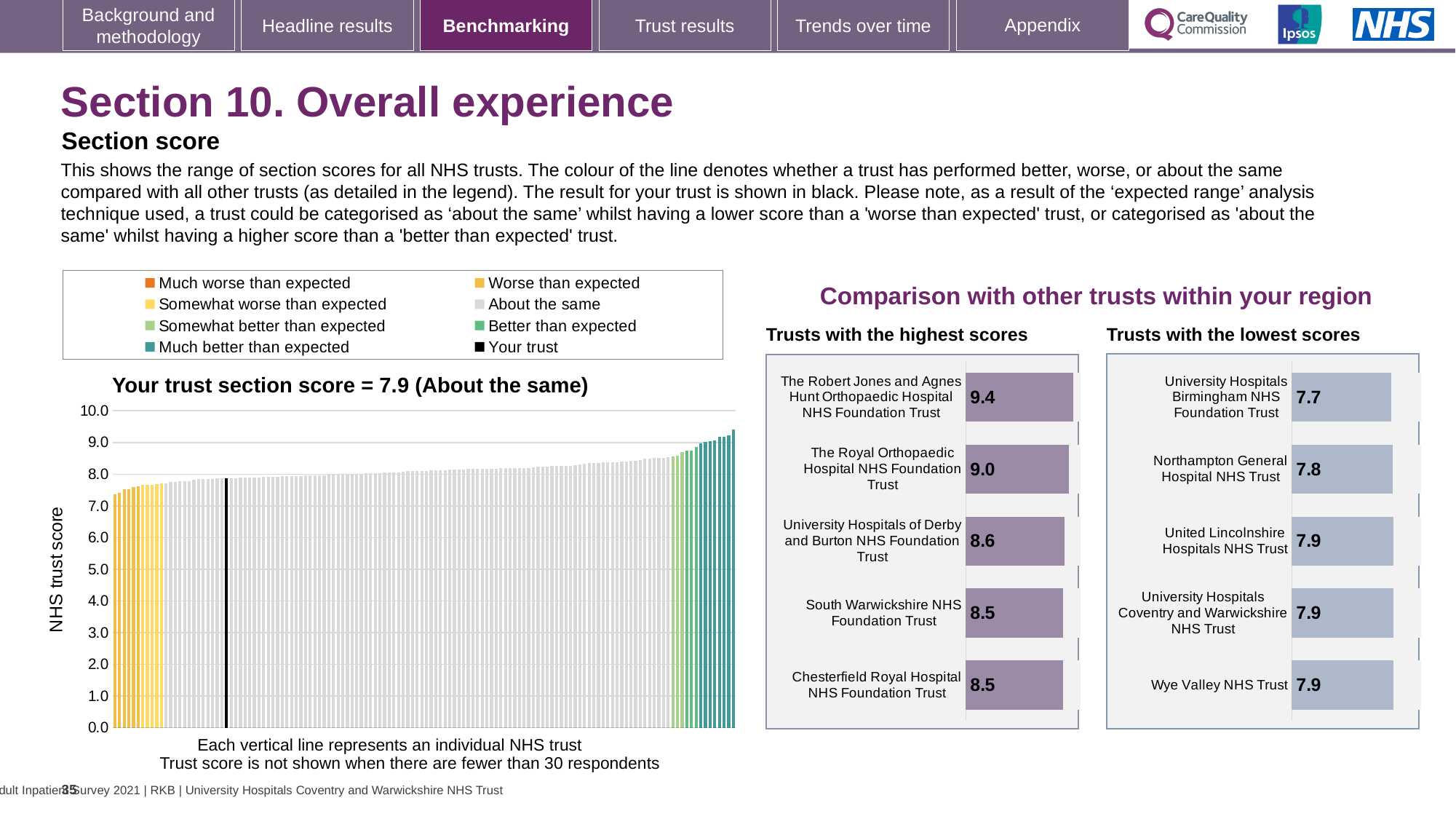
In the 'Trusts with the highest scores' chart, how many trusts are shown? 5 In the 'Trusts with the highest scores' chart, what is the score for University Hospitals of Derby and Burton NHS Foundation Trust? 8.6 How many entries does the legend above the 'Your trust section score' chart list? 8 In the 'Trusts with the lowest scores' chart, what is the score for Northampton General Hospital NHS Trust? 7.8 In the 'Your trust section score' chart, what is the section score for your trust? 7.9 In the 'Your trust section score' chart, do the bar values rise or fall from left to right? rise In the 'Trusts with the highest scores' chart, what is the difference between the scores of The Robert Jones and Agnes Hunt Orthopaedic Hospital NHS Foundation Trust and University Hospitals of Derby and Burton NHS Foundation Trust? 0.8 In the 'Trusts with the lowest scores' chart, which trust has the lowest score? University Hospitals Birmingham NHS Foundation Trust In the 'Trusts with the highest scores' chart, which trust has the highest score? The Robert Jones and Agnes Hunt Orthopaedic Hospital NHS Foundation Trust In the 'Your trust section score' chart, is the value of the tallest bar greater or less than 9.0? greater What kind of chart is the 'Your trust section score' chart? bar chart In the 'Your trust section score' chart, what is the label on the vertical axis? NHS trust score